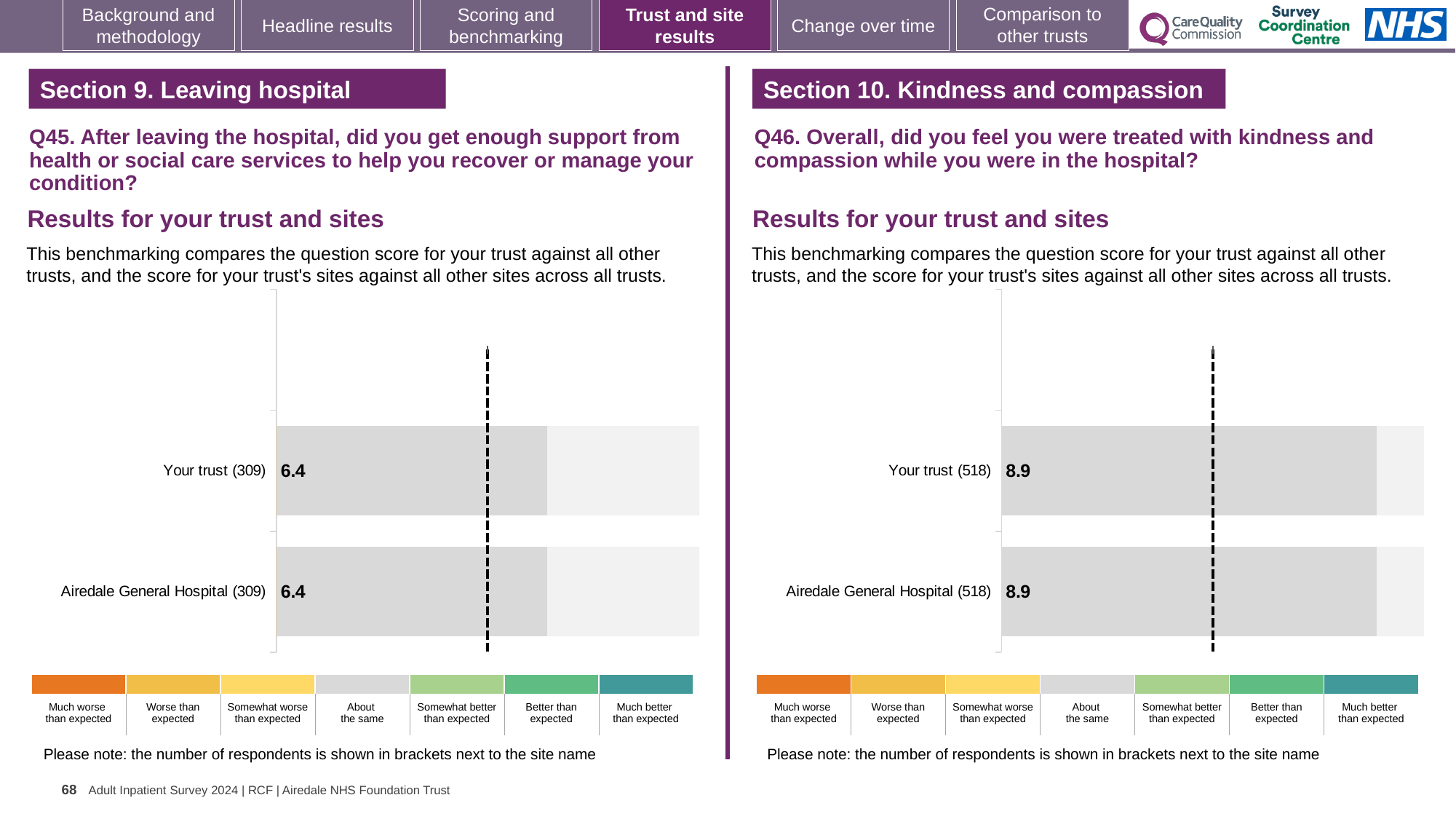
How many bars are plotted in the Q45 chart on the left? 2 In the Q46 chart on the right, what is the score for Your trust? 8.9 What kind of chart is used for the Q45 results on the left? Bar chart In the Q46 chart on the right, what is the difference between the score for Your trust and the score for Airedale General Hospital? 0 In the Q45 chart on the left, what is the difference between the score for Your trust and the score for Airedale General Hospital? 0 In the Q46 chart on the right, how many respondents are shown in brackets next to Airedale General Hospital? 518 In the Q45 chart on the left, what is the score for Airedale General Hospital? 6.4 How many bars are plotted in the Q46 chart on the right? 2 In the Q45 chart on the left, what is the score for Your trust? 6.4 In the Q46 chart on the right, what is the score for Airedale General Hospital? 8.9 In the Q45 chart on the left, how many respondents are shown in brackets next to Your trust? 309